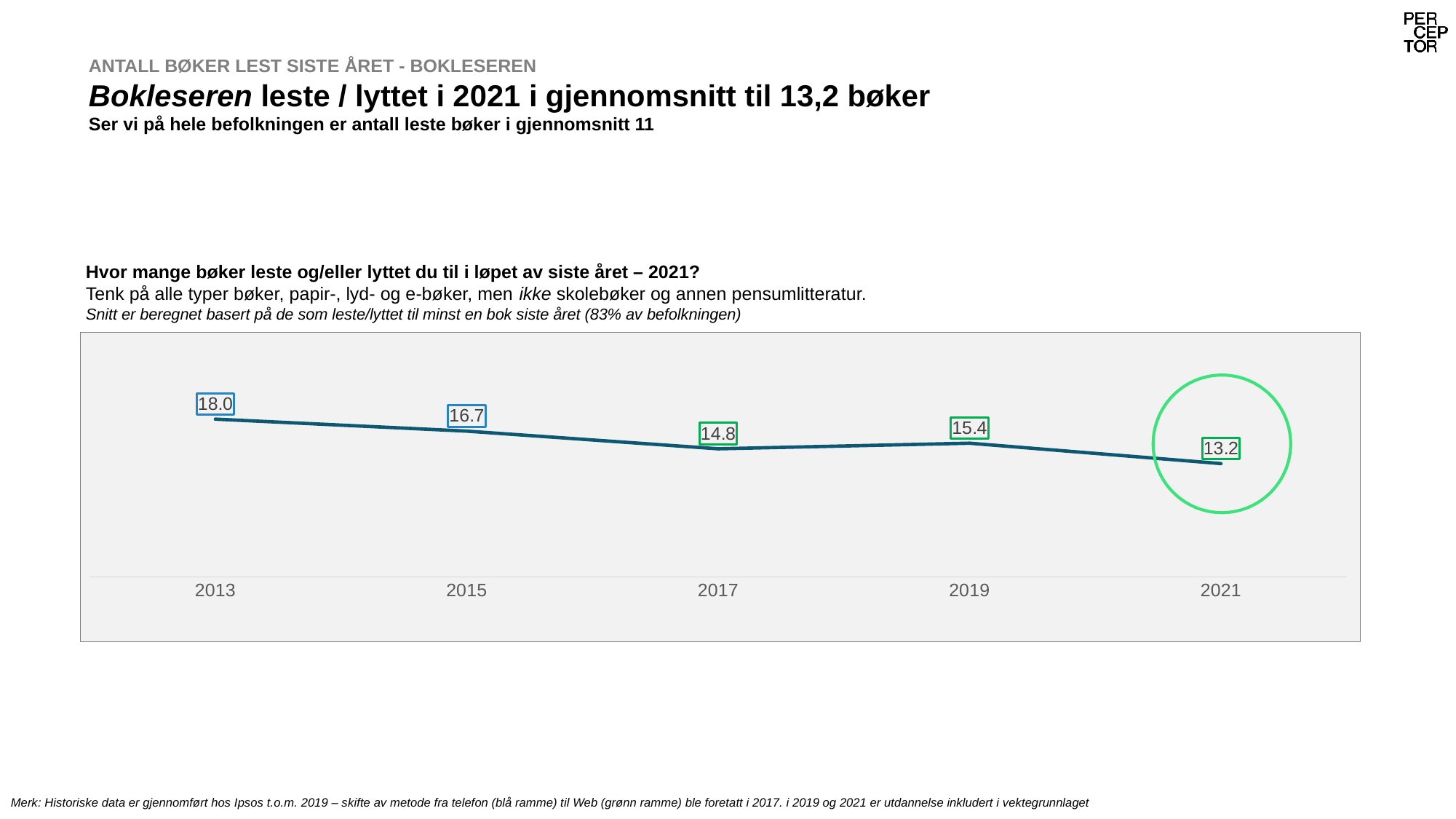
What is the difference between the values for 2013 and 2021? 4.8 What is the value for 2015? 16.7 Which year has the lowest value? 2021 Do the values generally rise or fall from 2013 to 2021? fall Which is larger, the value for 2017 or the value for 2019? 2019 How many years are plotted on the chart? 5 What is the value for 2021? 13.2 What is the value for 2019? 15.4 What is the value for 2013? 18.0 Which year has the highest value? 2013 What is the value for 2017? 14.8 What kind of chart is shown? line chart